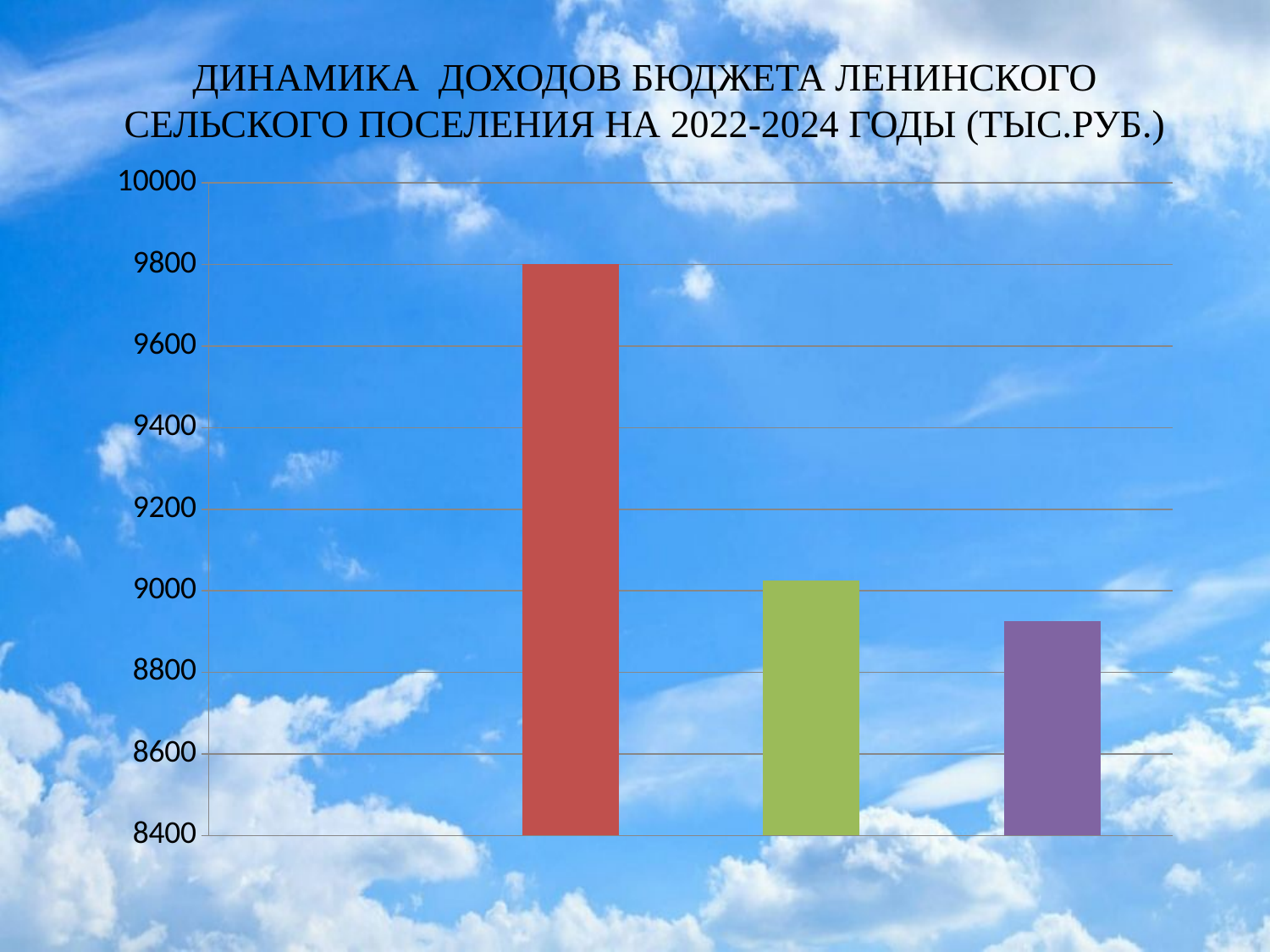
Is the value of the green bar greater or less than 9000? greater Is the value of the red bar greater or less than 9600? greater Which bar is taller, the green bar or the purple bar? the green bar What value does the top of the red bar reach on the vertical axis? 9800 How many bars are plotted in the chart? 3 Is the value of the purple bar greater or less than 9000? less What is the title of the chart? ДИНАМИКА ДОХОДОВ БЮДЖЕТА ЛЕНИНСКОГО СЕЛЬСКОГО ПОСЕЛЕНИЯ НА 2022-2024 ГОДЫ (ТЫС.РУБ.) Do the bar values rise or fall from left to right across the chart? fall What is the highest tick value shown on the vertical axis? 10000 Which bar is the highest in the chart? the red bar (leftmost) Which bar is the lowest in the chart? the purple bar (rightmost) What kind of chart is shown on the slide? bar chart